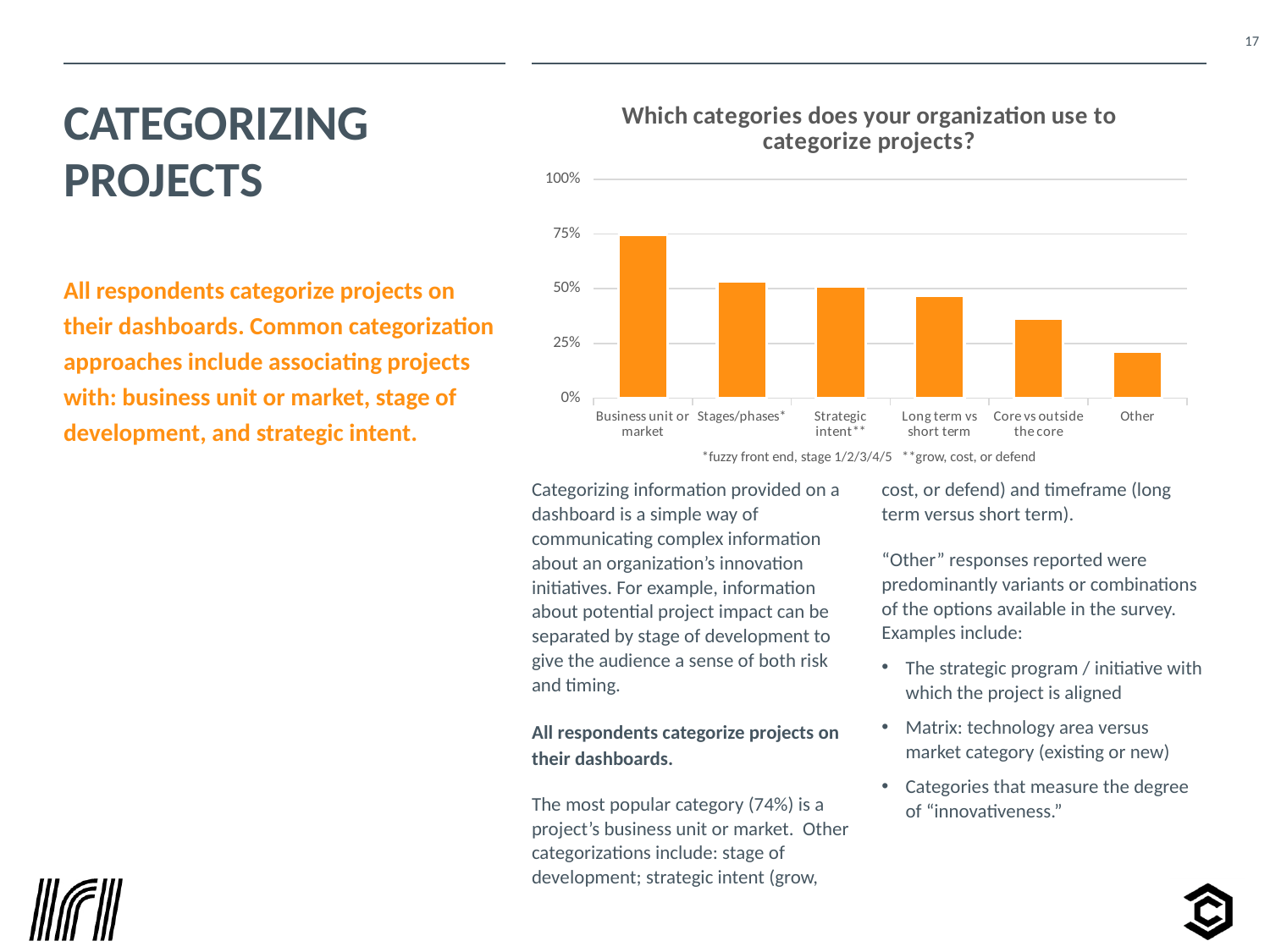
According to the slide, what percentage of respondents use business unit or market to categorize projects? 74% What is the title of the chart? Which categories does your organization use to categorize projects? How many categories are shown on the x axis of the chart? 6 What colour are the bars in the chart? Orange Which category has the highest value in the chart? Business unit or market Is the value for Core vs outside the core greater or less than 50%? less Do the bar values rise or fall moving from left to right along the x axis? Fall Which is larger, the value for Stages/phases or the value for Core vs outside the core? Stages/phases Which category has the lowest value in the chart? Other What type of chart is shown on the slide? Bar chart Is the value for Other greater or less than 25%? less Is the value for Business unit or market greater or less than 50%? greater